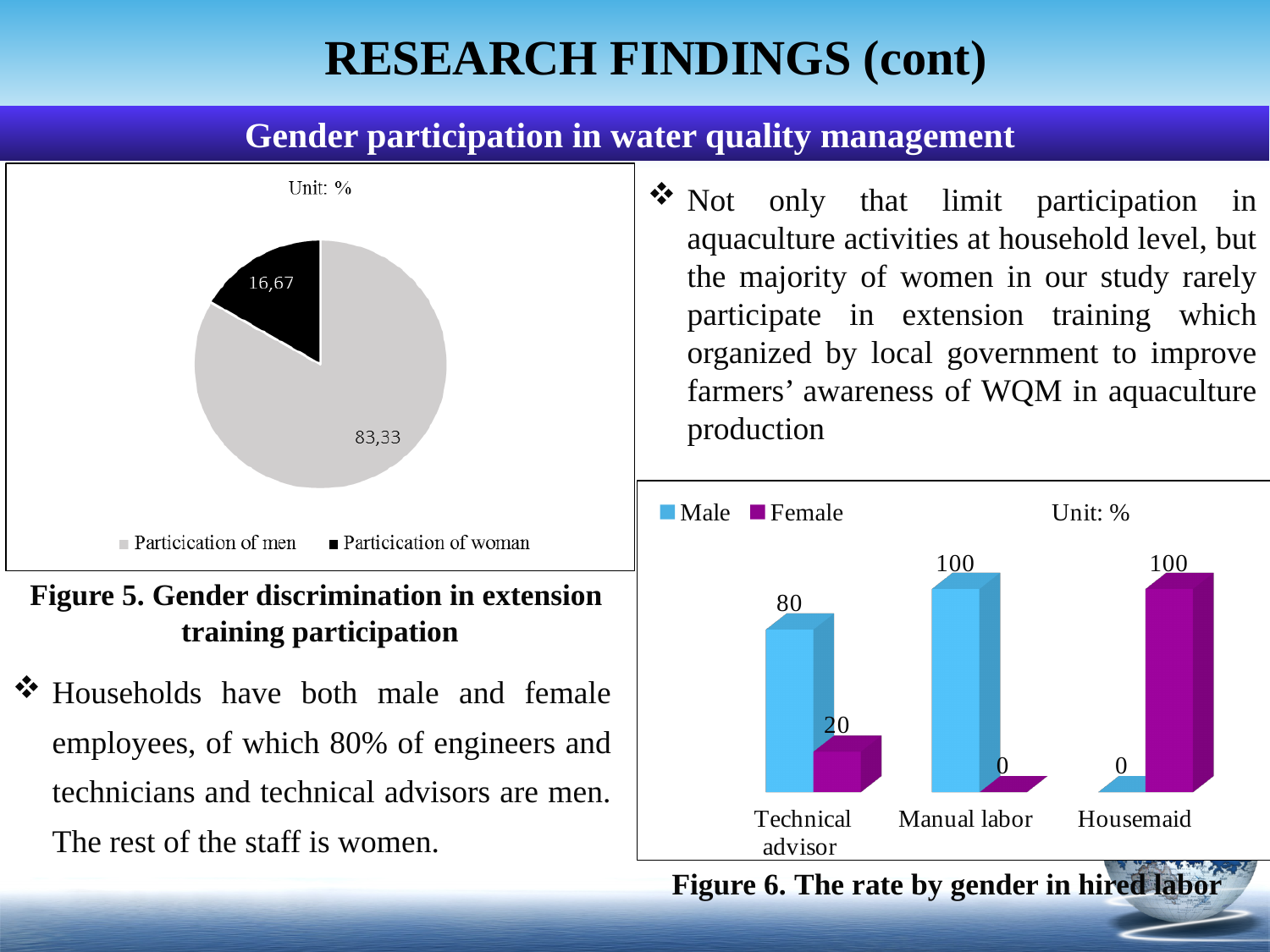
In the bar chart (Figure 6), what is the Female value for Technical advisor? 20 In the bar chart (Figure 6), which category has the lowest Male value? Housemaid In the bar chart (Figure 6), what is the difference between the Male and Female values for Technical advisor? 60 In the bar chart (Figure 6), what is the Female value for Housemaid? 100 In the bar chart (Figure 6), how many categories are shown on the x axis? 3 In the bar chart (Figure 6), what is the Male value for Technical advisor? 80 What kind of chart is Figure 5? pie chart In the pie chart (Figure 5), what unit is shown above the chart? % In the bar chart (Figure 6), how many series does the legend list? 2 In the pie chart (Figure 5), which category has the larger share? Particication of men In the pie chart (Figure 5), what is the value for Particication of woman? 16,67 In the pie chart (Figure 5), what is the value for Particication of men? 83,33